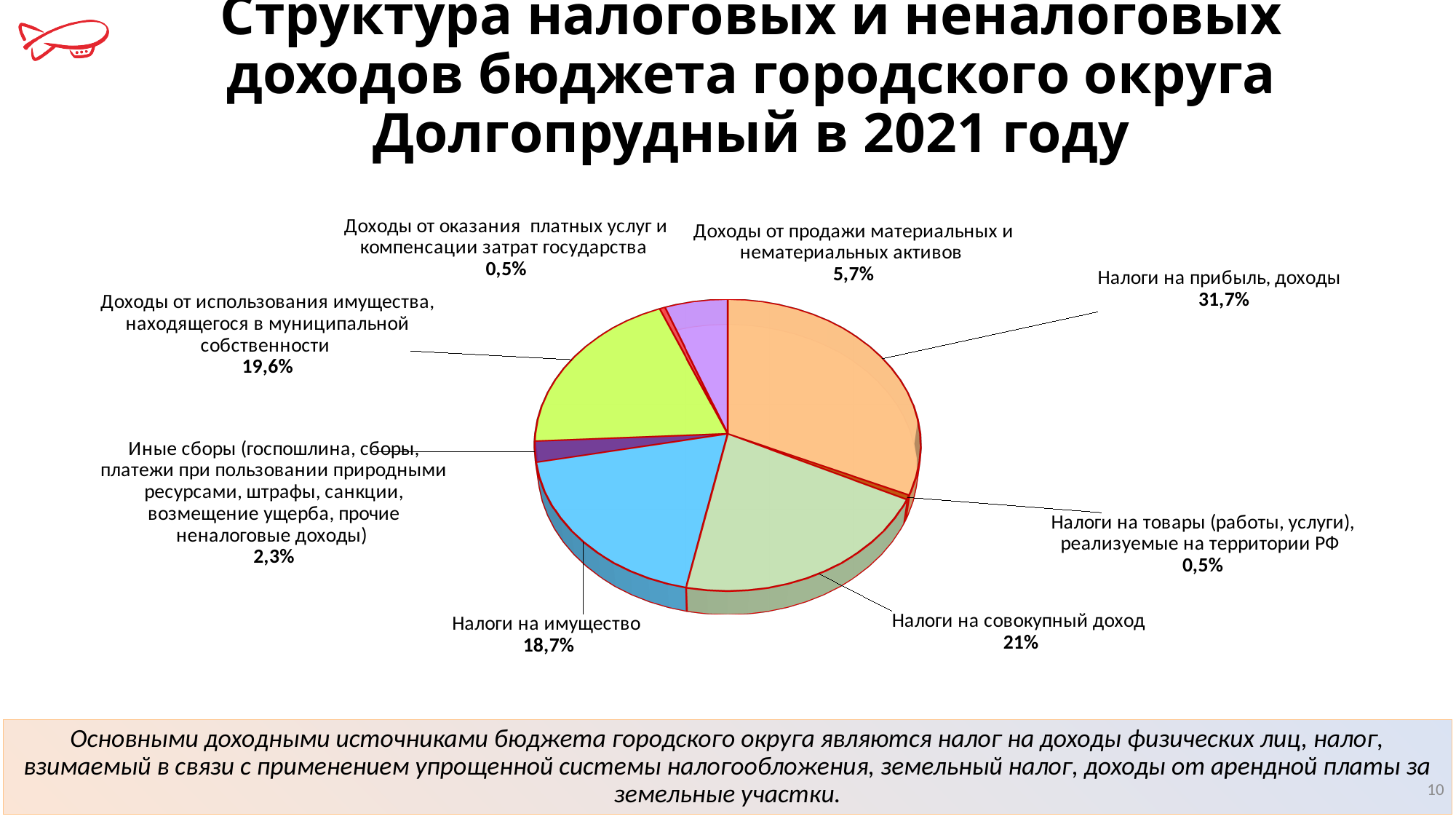
How many slices does the pie chart have? 8 Which is larger: the share for "Доходы от использования имущества, находящегося в муниципальной собственности" or for "Налоги на имущество"? Доходы от использования имущества, находящегося в муниципальной собственности What year does the chart title refer to? 2021 What share is shown for "Иные сборы (госпошлина, сборы, платежи при пользовании природными ресурсами, штрафы, санкции, возмещение ущерба, прочие неналоговые доходы)"? 2,3% What percentage is shown for "Налоги на совокупный доход"? 21% Which category has the largest share of the pie? Налоги на прибыль, доходы By how many percentage points does "Налоги на прибыль, доходы" exceed "Налоги на совокупный доход"? 10,7 What type of chart is shown on the slide? Pie chart What share of the budget revenue comes from "Налоги на прибыль, доходы"? 31,7% What percentage is shown for "Налоги на имущество"? 18,7% What share is shown for "Доходы от продажи материальных и нематериальных активов"? 5,7% What percentage is shown for "Доходы от использования имущества, находящегося в муниципальной собственности"? 19,6%